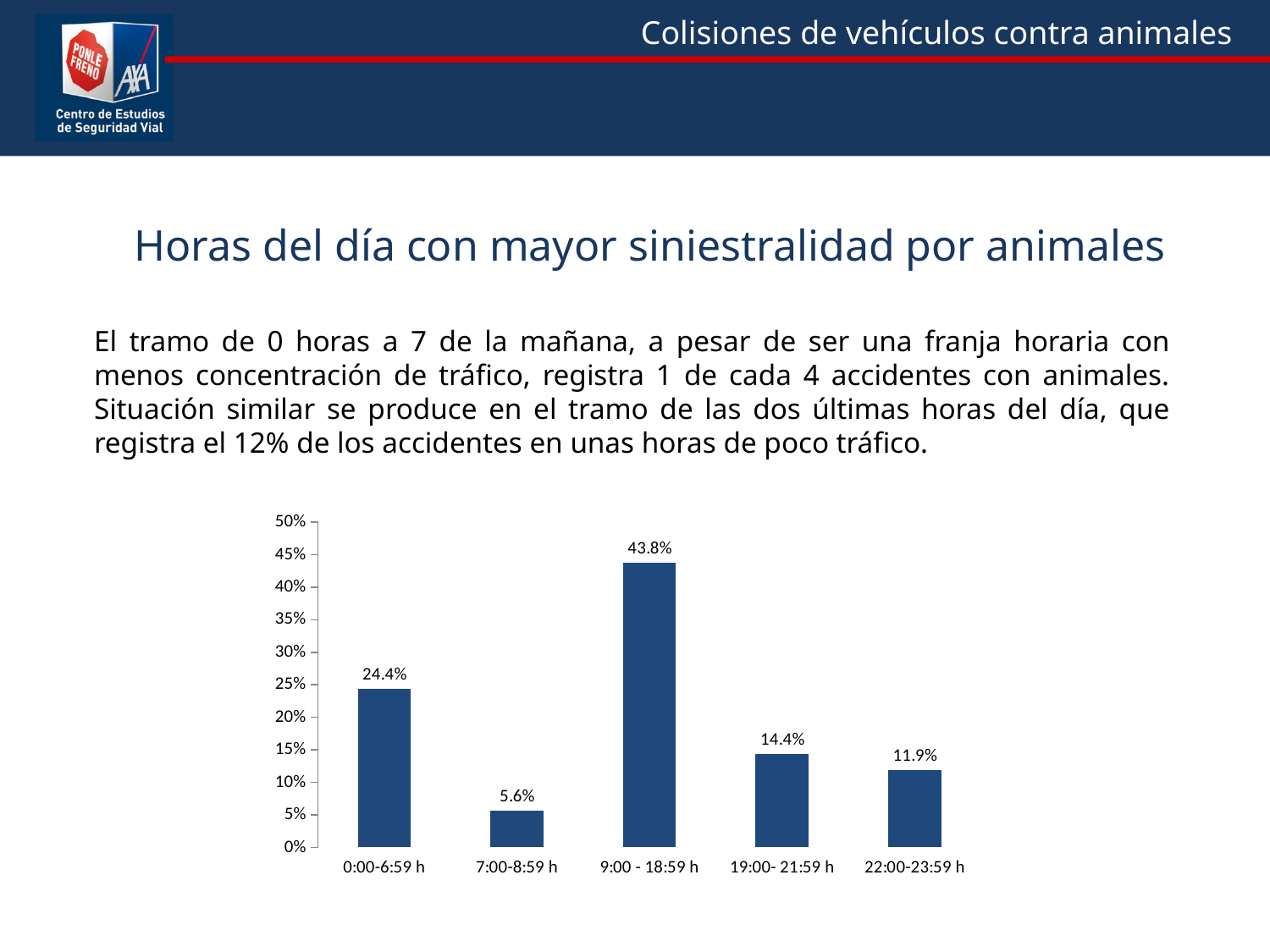
What kind of chart is shown on the slide? bar chart What is the title of the slide above the chart? Horas del día con mayor siniestralidad por animales What is the difference between the values for 19:00- 21:59 h and 22:00-23:59 h? 2.5% Which is larger, the value for 0:00-6:59 h or the value for 19:00- 21:59 h? 0:00-6:59 h What is the difference between the values for 9:00 - 18:59 h and 0:00-6:59 h? 19.4% What is the value for the 22:00-23:59 h time slot? 11.9% What is the value for the 9:00 - 18:59 h time slot? 43.8% How many time slots are shown on the x axis? 5 Which time slot has the lowest value? 7:00-8:59 h Which time slot has the highest value? 9:00 - 18:59 h Is the value for 7:00-8:59 h greater or less than 10%? less What is the value for the 0:00-6:59 h time slot? 24.4%